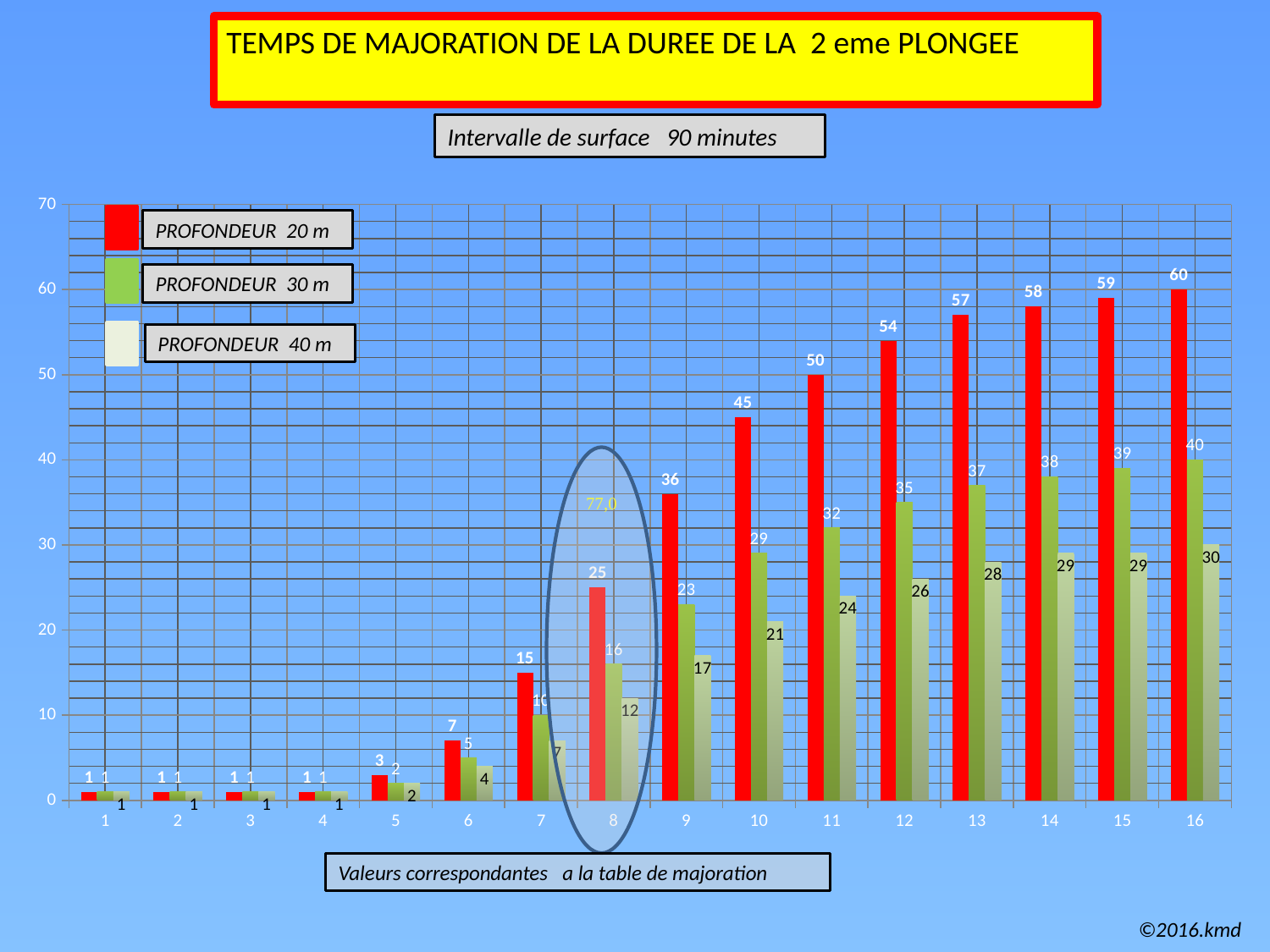
What kind of chart is shown on the slide? Bar chart How many categories are shown on the x axis? 16 What is the value for PROFONDEUR 40 m at category 12? 26 What is the value for PROFONDEUR 20 m at category 16? 60 Do the PROFONDEUR 20 m values rise or fall from category 1 to category 16? Rise Which category has the highest value for PROFONDEUR 20 m? 16 What surface interval is stated on the slide? 90 minutes What is the difference between the PROFONDEUR 20 m and PROFONDEUR 40 m values at category 8? 13 What is the difference between the PROFONDEUR 20 m and PROFONDEUR 30 m values at category 16? 20 How many series does the legend list? 3 What is the value for PROFONDEUR 30 m at category 10? 29 At category 9, which series has the larger value, PROFONDEUR 20 m or PROFONDEUR 40 m? PROFONDEUR 20 m